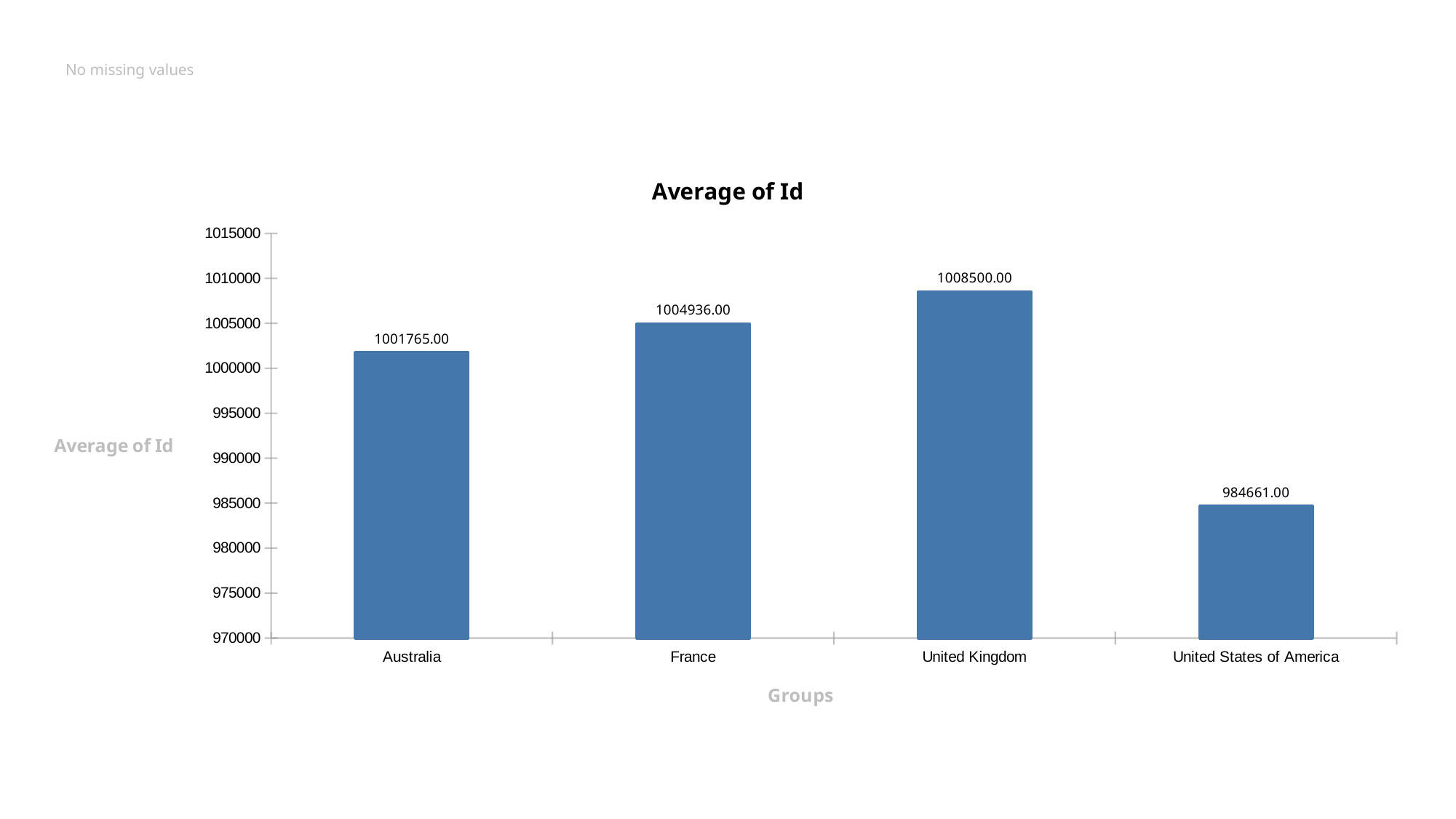
What is the value for United States of America? 984661.00 How many groups are shown on the x axis? 4 What is the value for Australia? 1001765.00 What kind of chart is this? bar chart What is the value for France? 1004936.00 Is the value for United States of America greater or less than 990000? less What is the difference between the values for France and United States of America? 20275.00 Which group has the lowest value? United States of America Which group has the highest value? United Kingdom What is the value for United Kingdom? 1008500.00 What is the difference between the values for United Kingdom and Australia? 6735.00 Which is larger, the value for France or the value for Australia? France